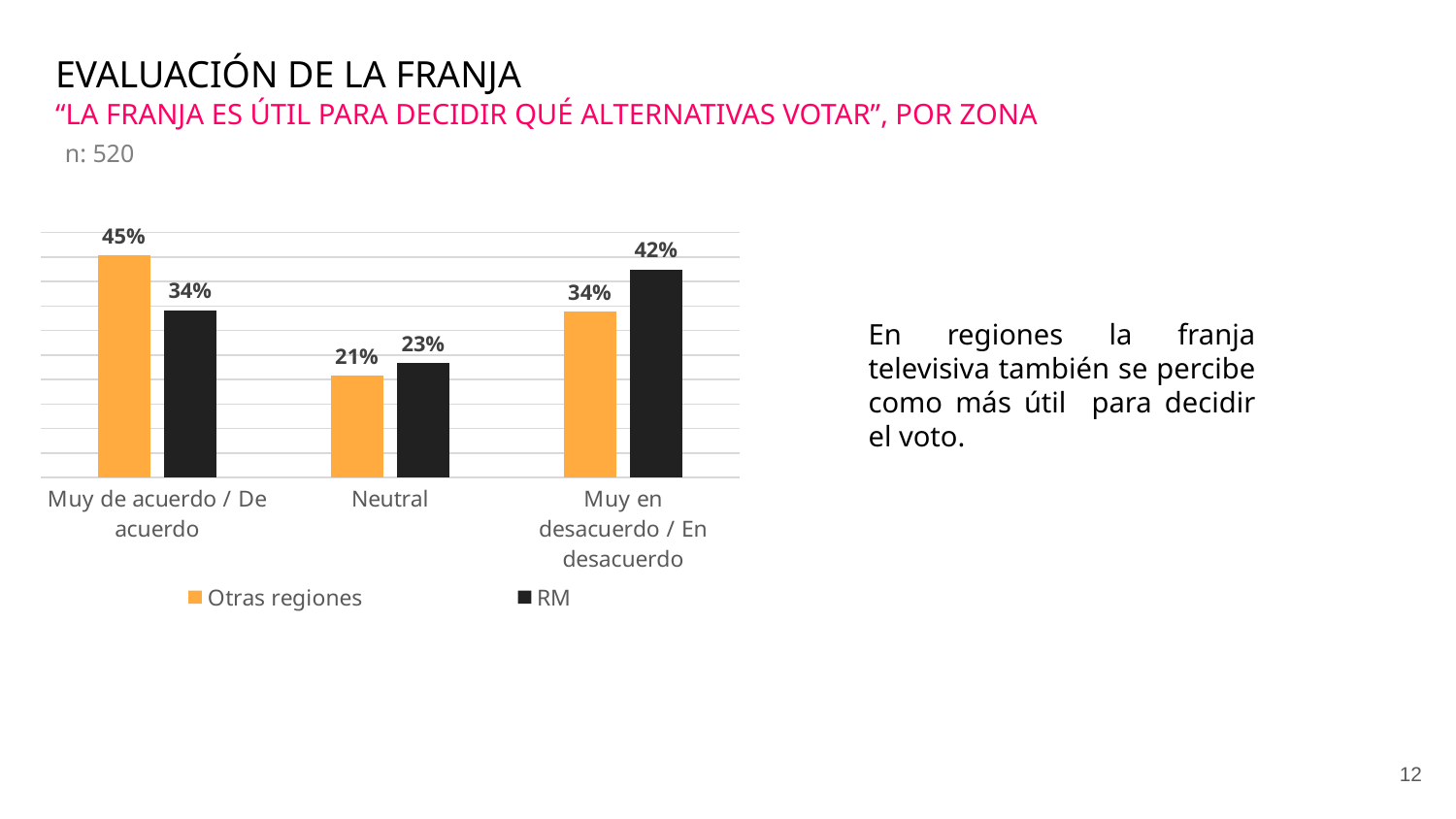
What is the value for Otras regiones in the Neutral category? 21% What is the value for RM in the Neutral category? 23% Which category has the highest value for the RM series? Muy en desacuerdo / En desacuerdo Which series has the larger value in the Muy en desacuerdo / En desacuerdo category, Otras regiones or RM? RM How many series does the legend list? 2 How many categories are shown on the x axis? 3 Which category has the lowest value for the Otras regiones series? Neutral Which colour represents the RM series in the chart? Black What kind of chart is shown on the slide? Bar chart What is the difference between Otras regiones and RM in the Muy de acuerdo / De acuerdo category? 11% What is the value for RM in the Muy en desacuerdo / En desacuerdo category? 42% What is the value for Otras regiones in the Muy de acuerdo / De acuerdo category? 45%